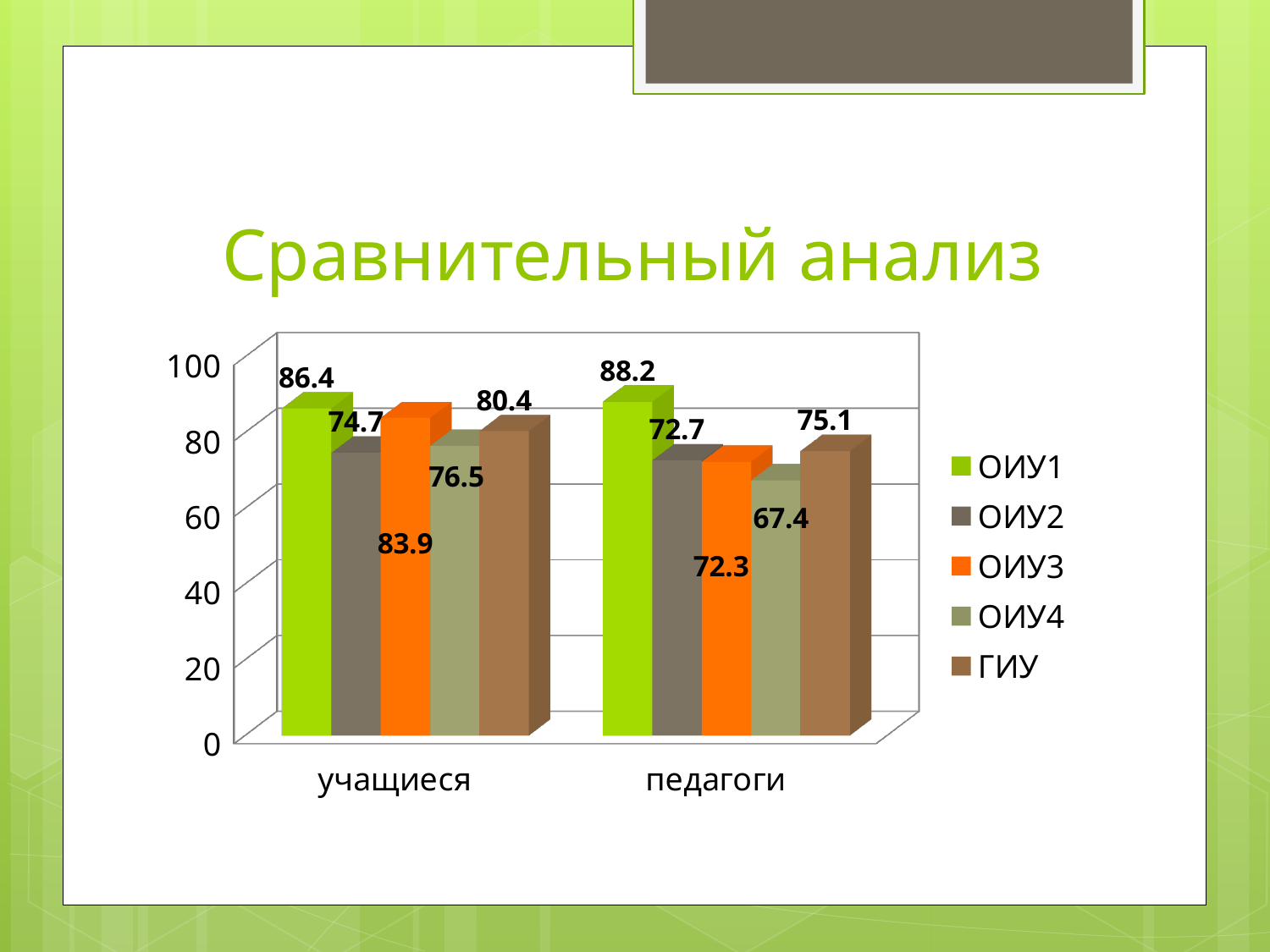
What is the value for ОИУ4 in the педагоги category? 67.4 Which series has the lowest value in the учащиеся category? ОИУ2 What is the value for ОИУ1 in the учащиеся category? 86.4 Which series has the highest value in the педагоги category? ОИУ1 How many categories are shown on the x axis? 2 What is the value for ГИУ in the педагоги category? 75.1 What is the title of the slide containing the chart? Сравнительный анализ Which is larger: the ГИУ value for учащиеся or for педагоги? учащиеся What is the value for ОИУ3 in the учащиеся category? 83.9 What is the difference between the ОИУ1 values for педагоги and учащиеся? 1.8 What kind of chart is shown on the slide? bar chart How many series does the legend list? 5